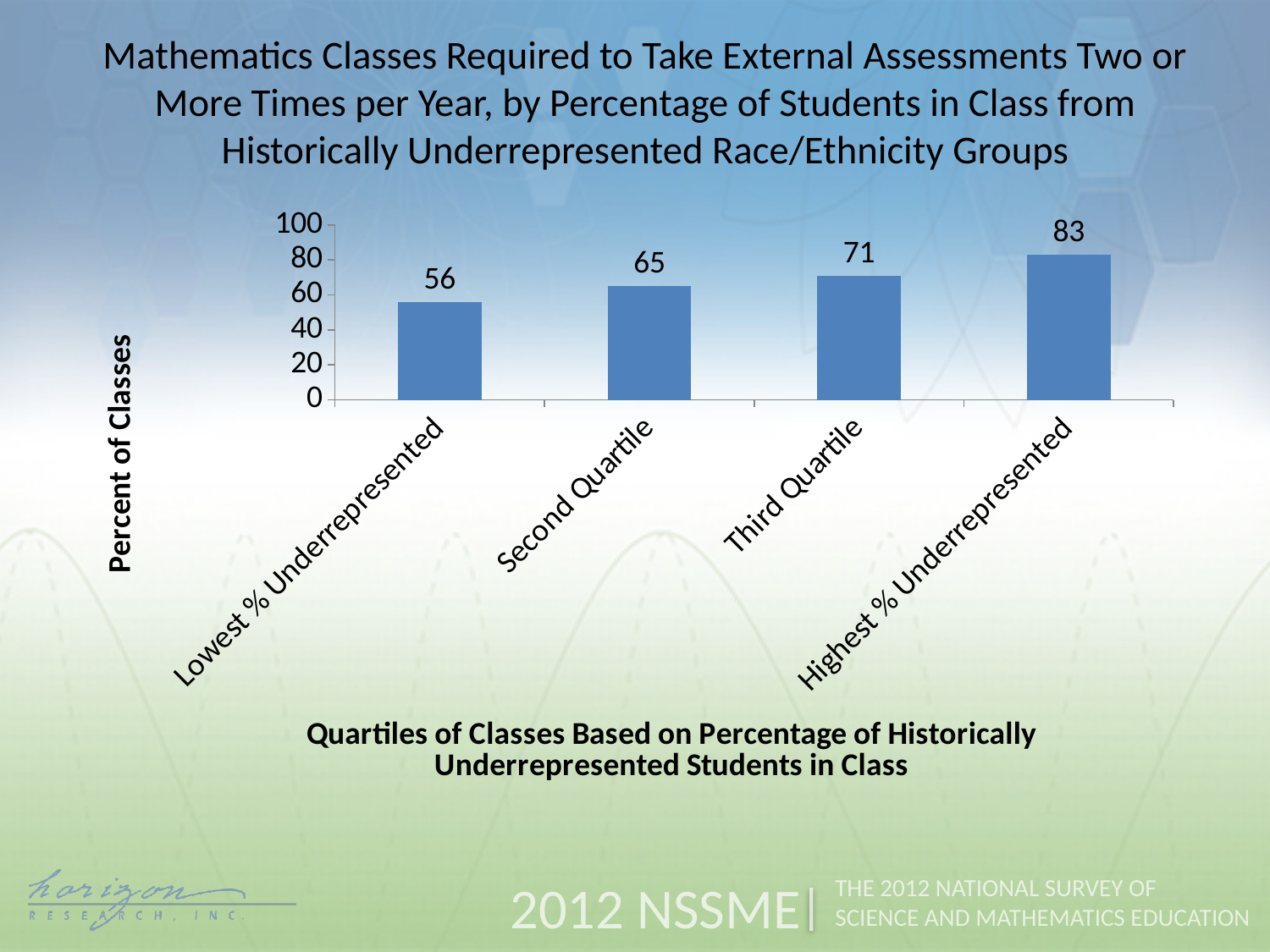
Which category has the highest value? Highest % Underrepresented What is the label of the vertical axis? Percent of Classes What is the difference between the values for Highest % Underrepresented and Lowest % Underrepresented? 27 What is the value for Third Quartile? 71 Which is larger, the value for Second Quartile or the value for Third Quartile? Third Quartile How many categories are shown on the x axis? 4 What is the value for Highest % Underrepresented? 83 What kind of chart is shown on the slide? Bar chart Do the values rise or fall from Lowest % Underrepresented to Highest % Underrepresented? Rise Which category has the lowest value? Lowest % Underrepresented What is the value for Second Quartile? 65 What is the value for Lowest % Underrepresented? 56